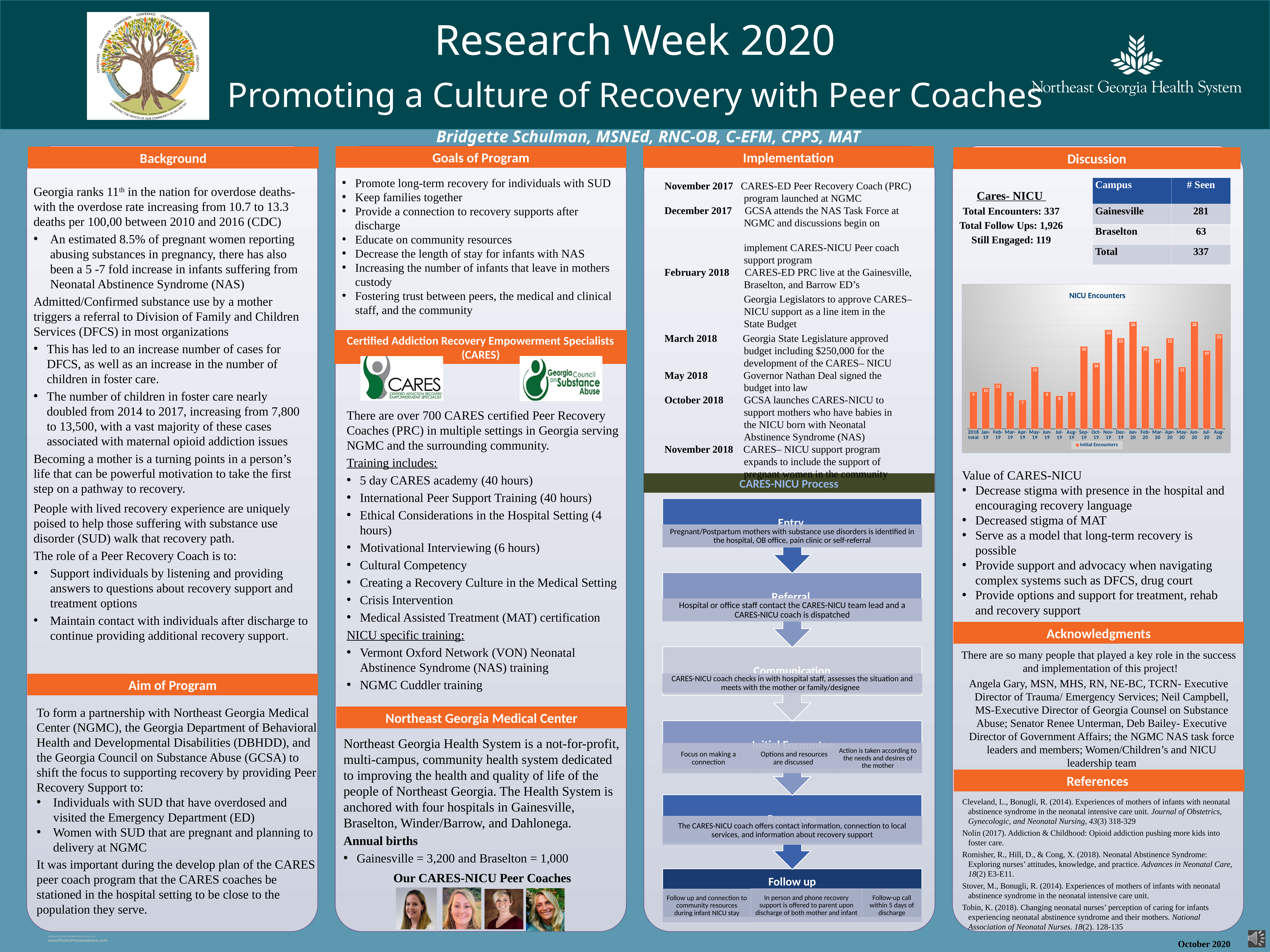
What is the title of the chart on the slide? NICU Encounters What is the highest value shown in the NICU Encounters chart? 26 Which category has the lowest value in the NICU Encounters chart? Apr-19 How many categories are shown on the x axis of the NICU Encounters chart? 21 What is the difference between the values for Jan-20 and Feb-20 in the NICU Encounters chart? 6 What is the value for Sep-19 in the NICU Encounters chart? 20 Which is larger in the NICU Encounters chart, the value for Oct-19 or the value for Nov-19? Nov-19 What type of chart is the NICU Encounters chart? bar chart What is the value for May-19 in the NICU Encounters chart? 15 How many series does the legend of the NICU Encounters chart list? 1 What is the value for Dec-19 in the NICU Encounters chart? 22 What is the legend entry shown on the NICU Encounters chart? Initial Encounters